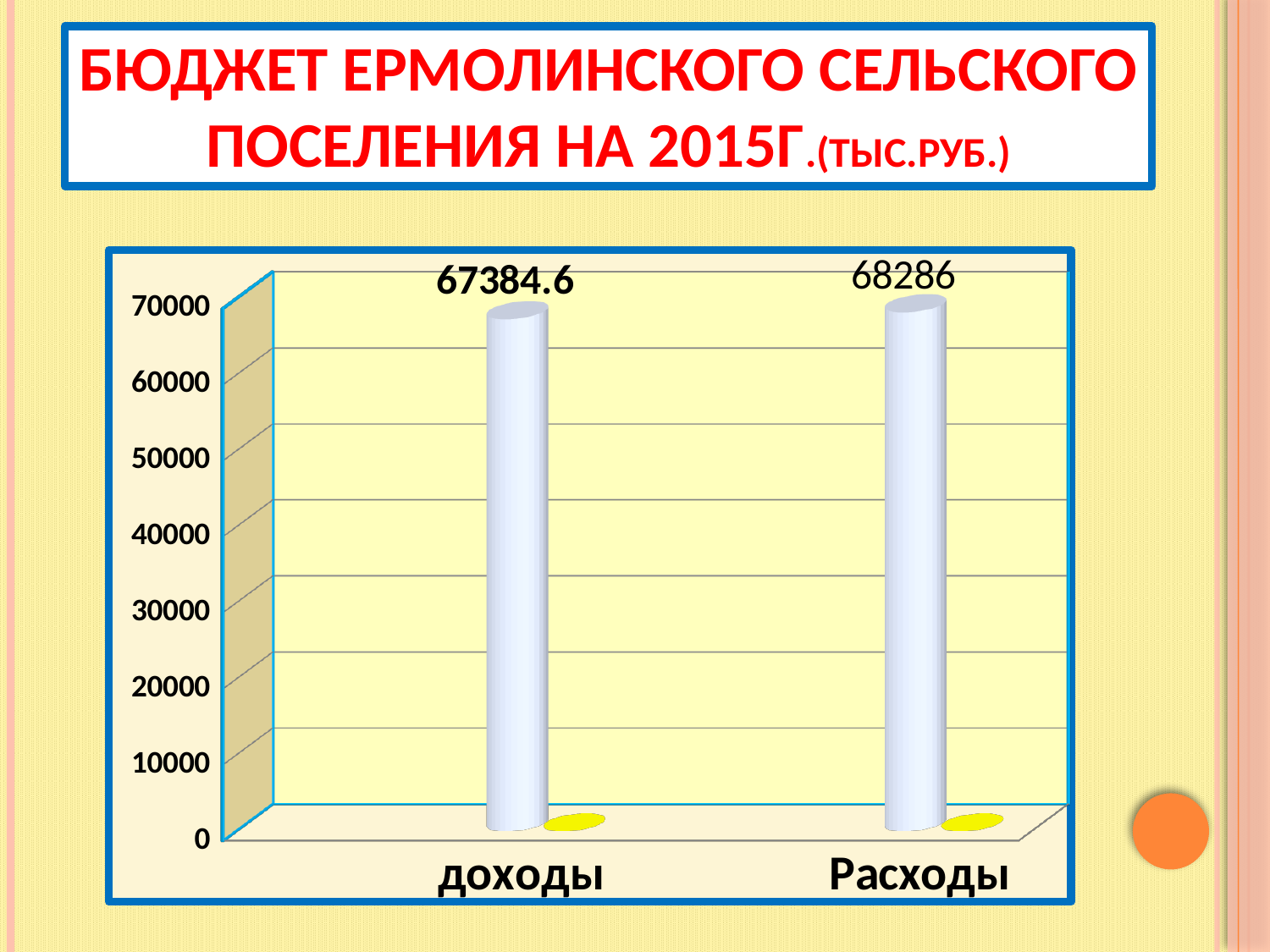
Is the value for Расходы greater or less than 70000? less What kind of chart is shown on the slide? bar chart Which is larger, the value for доходы or the value for Расходы? Расходы Is the value for доходы greater or less than 60000? greater How many categories are shown on the chart? 2 What is the title of the slide? БЮДЖЕТ ЕРМОЛИНСКОГО СЕЛЬСКОГО ПОСЕЛЕНИЯ НА 2015Г.(ТЫС.РУБ.) Do the values rise or fall from доходы to Расходы? rise What is the value for Расходы? 68286 Which category has the higher value? Расходы What is the difference between the values for Расходы and доходы? 901.4 What is the value for доходы? 67384.6 Which category has the lower value? доходы